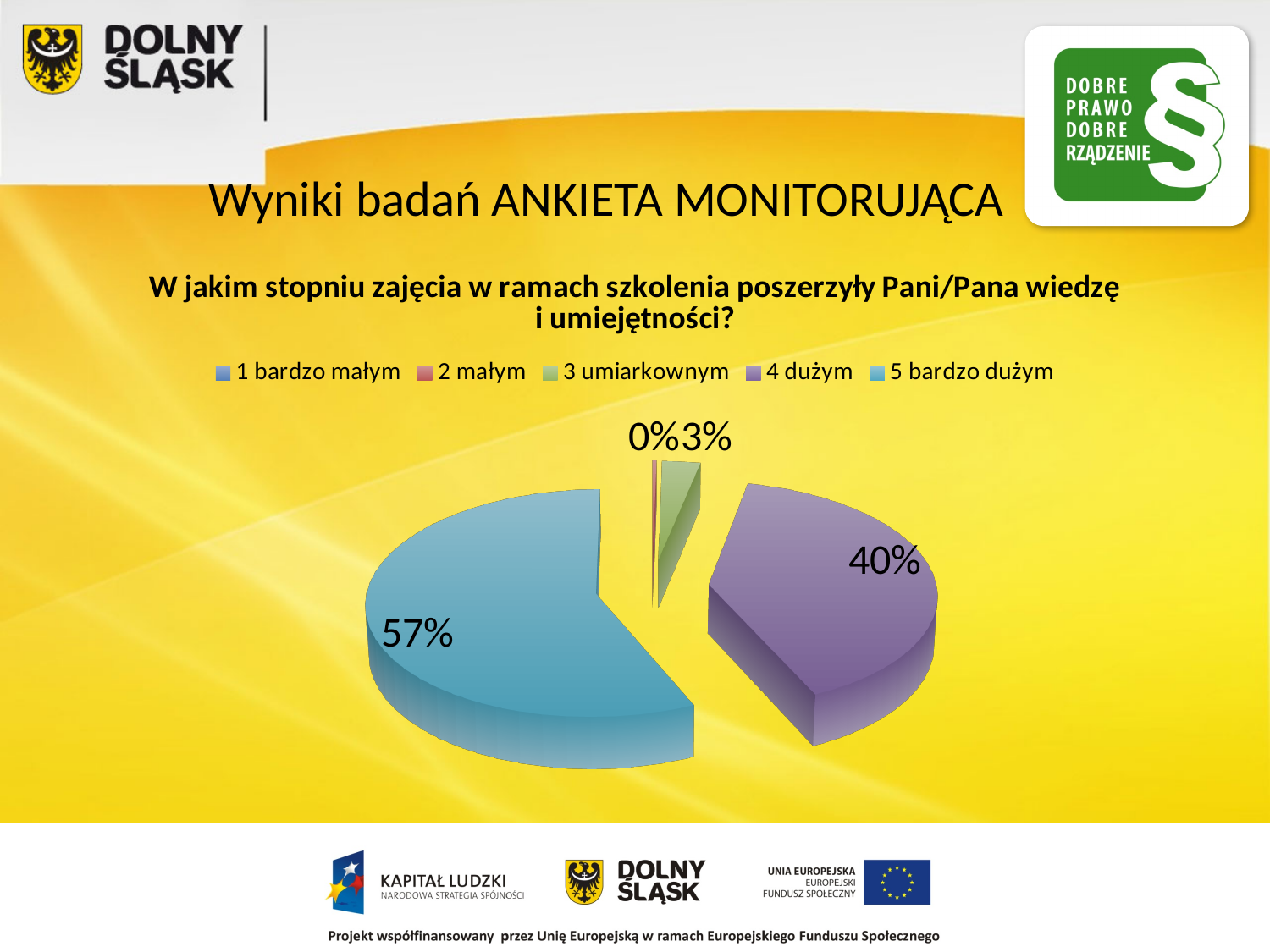
Which answer category has the largest slice of the pie? 5 bardzo dużym What share of respondents answered "3 umiarkowanym"? 3% How many percentage points larger is the "5 bardzo dużym" slice than the "4 dużym" slice? 17 percentage points What kind of chart is shown on the slide? pie chart What colour is the "5 bardzo dużym" slice? light blue What question is the pie chart about, as shown in the chart title? W jakim stopniu zajęcia w ramach szkolenia poszerzyły Pani/Pana wiedzę i umiejętności? Which slice is larger: "4 dużym" or "5 bardzo dużym"? 5 bardzo dużym What share of respondents answered "4 dużym"? 40% What share of respondents answered "5 bardzo dużym"? 57% How many percentage points larger is the "4 dużym" slice than the "3 umiarkowanym" slice? 37 percentage points How many answer categories does the legend list? 5 Which slice is larger: "3 umiarkowanym" or "4 dużym"? 4 dużym